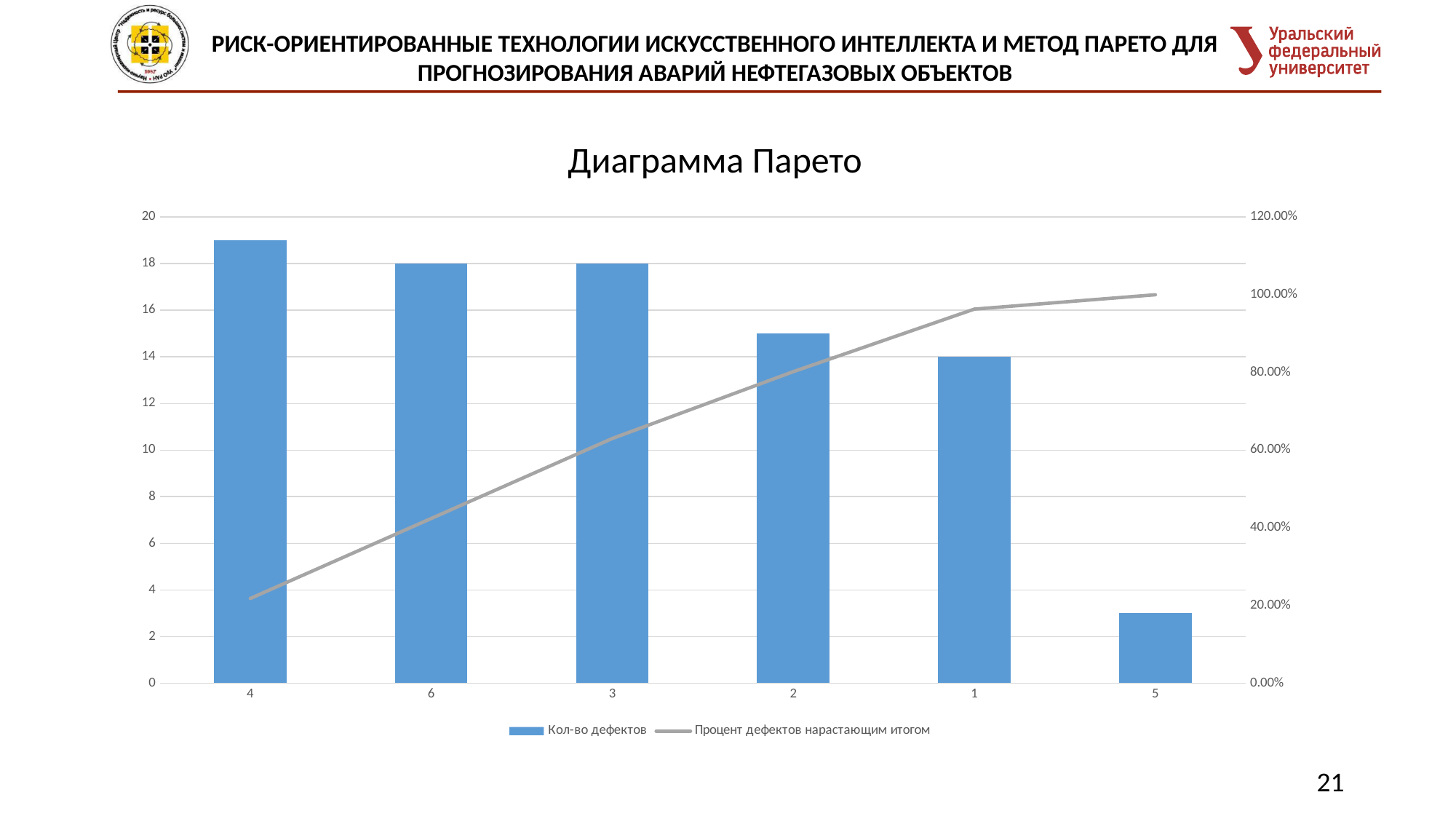
Do the Кол-во дефектов bars rise or fall from left to right along the x axis? fall What is the difference in Кол-во дефектов between category 6 and category 1? 4 Which category has the lowest Кол-во дефектов? 5 How many series does the legend list? 2 How many categories are shown on the x axis? 6 What is the value of Кол-во дефектов for category 3? 18 Is the Кол-во дефектов value for category 2 greater or less than 16? less What is the value of Кол-во дефектов for category 6? 18 Is the Процент дефектов нарастающим итогом value at category 1 greater or less than 80.00%? greater Which category has the highest Кол-во дефектов? 4 Is the Кол-во дефектов value for category 5 greater or less than 4? less What is the value of Кол-во дефектов for category 1? 14